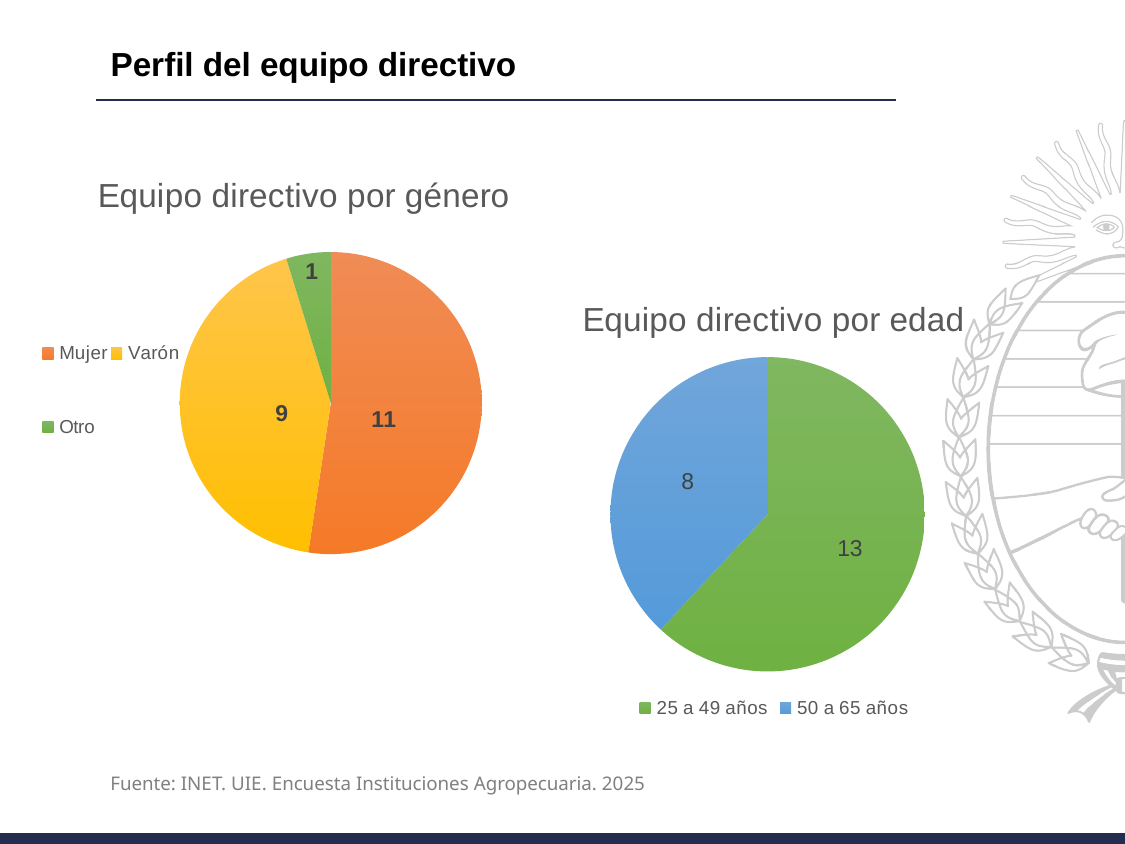
In the 'Equipo directivo por género' chart, how many categories are shown? 3 What kind of chart is 'Equipo directivo por edad'? Pie chart In the 'Equipo directivo por edad' chart, what is the value for 25 a 49 años? 13 In the 'Equipo directivo por género' chart, what is the difference between the values for Mujer and Varón? 2 In the 'Equipo directivo por género' chart, which category has the smallest slice? Otro In the 'Equipo directivo por género' chart, what is the value for Otro? 1 In the 'Equipo directivo por género' chart, what is the value for Mujer? 11 In the 'Equipo directivo por edad' chart, what is the value for 50 a 65 años? 8 In the 'Equipo directivo por edad' chart, which is larger, 25 a 49 años or 50 a 65 años? 25 a 49 años In the 'Equipo directivo por género' chart, which category has the largest slice? Mujer In the 'Equipo directivo por género' chart, what is the value for Varón? 9 In the 'Equipo directivo por edad' chart, what is the difference between the two slices? 5